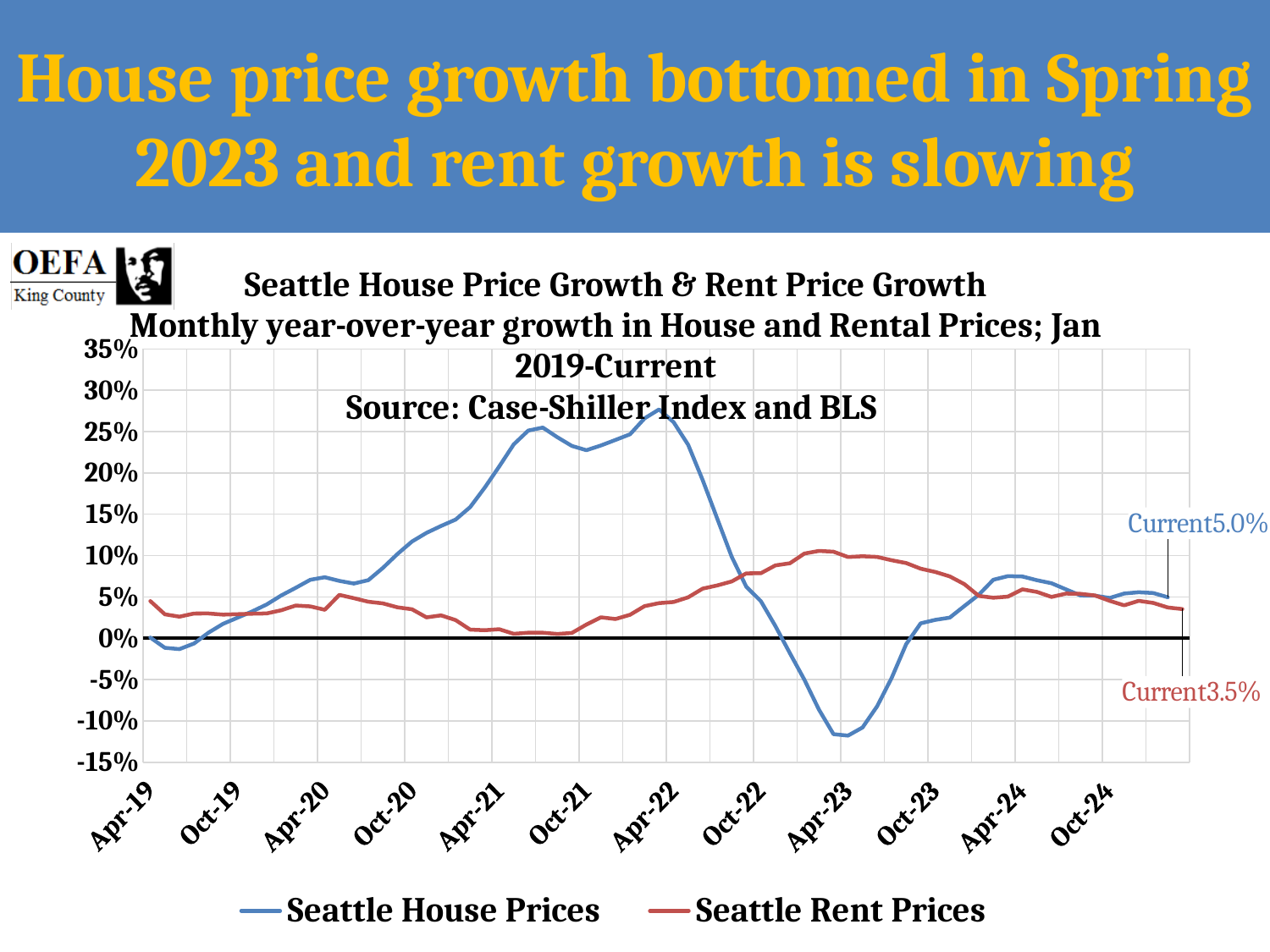
Do Seattle Rent Prices rise or fall between Apr-23 and Oct-24? Fall Is the peak value for Seattle House Prices around Apr-22 greater or less than 25%? greater How many series does the legend list? 2 Is the lowest value for Seattle House Prices around Apr-23 greater or less than -10%? less What kind of chart is shown on the slide? Line chart Is the value for Seattle Rent Prices around Apr-23 greater or less than 5%? greater What is the current value labelled for Seattle House Prices? 5.0% What is the difference between the current values for Seattle House Prices and Seattle Rent Prices? 1.5% Which series reaches the highest value anywhere on the chart? Seattle House Prices What is the current value labelled for Seattle Rent Prices? 3.5% Which series has the higher current value, Seattle House Prices or Seattle Rent Prices? Seattle House Prices What source is cited for the chart data? Case-Shiller Index and BLS